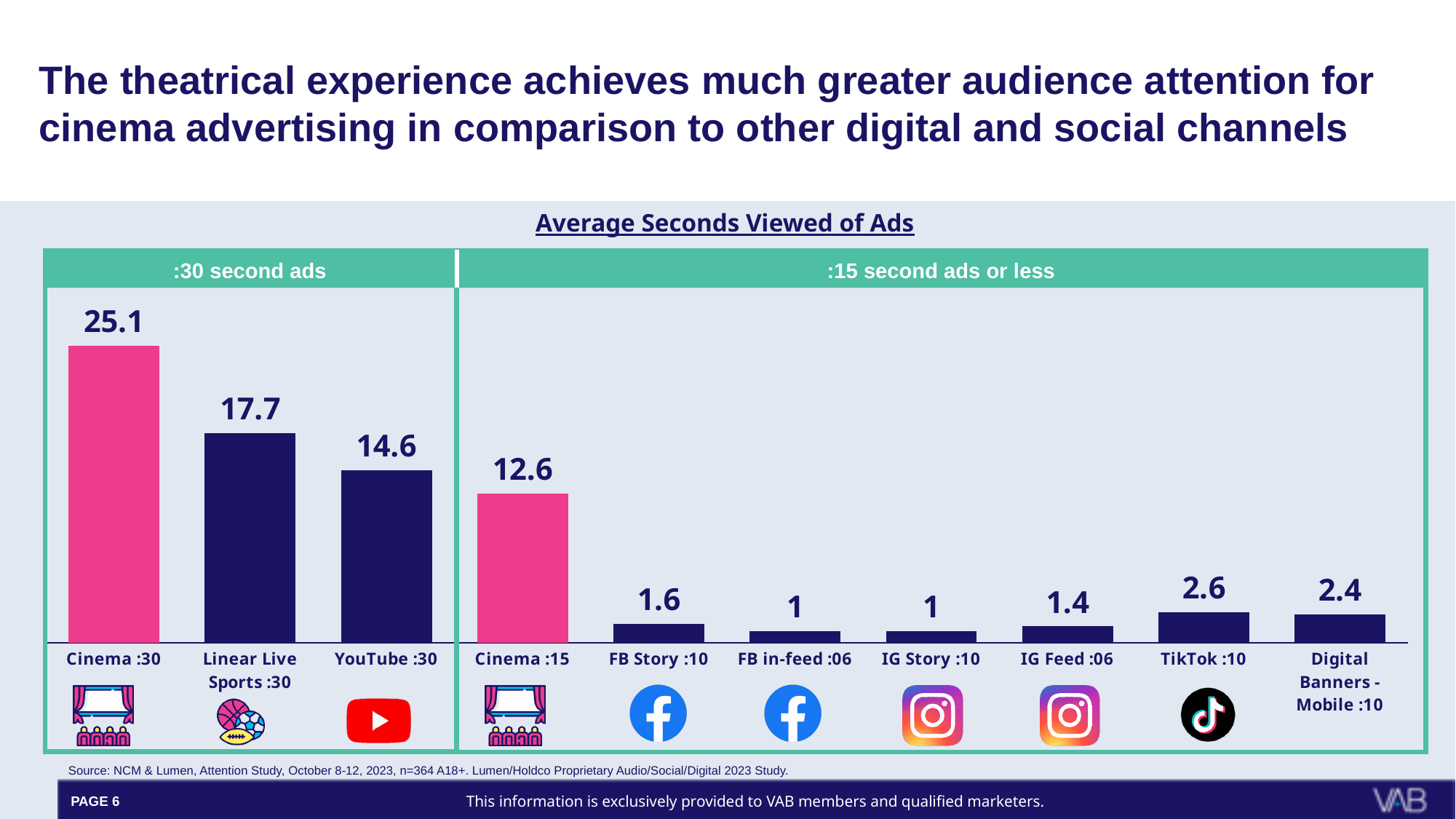
What is the average seconds viewed of ads for Cinema :30? 25.1 Which category has the highest average seconds viewed of ads? Cinema :30 What is the value shown for TikTok :10? 2.6 What is the title of the chart? Average Seconds Viewed of Ads Which has a higher value, Linear Live Sports :30 or YouTube :30? Linear Live Sports :30 How many categories are plotted in the chart? 10 What is the average seconds viewed of ads for Linear Live Sports :30? 17.7 Which categories have the lowest average seconds viewed of ads? FB in-feed :06 and IG Story :10 What is the difference in average seconds viewed between Cinema :30 and YouTube :30? 10.5 What is the value shown for Digital Banners - Mobile :10? 2.4 What is the difference in average seconds viewed between Cinema :15 and FB Story :10? 11 What kind of chart is shown on the slide? Bar chart